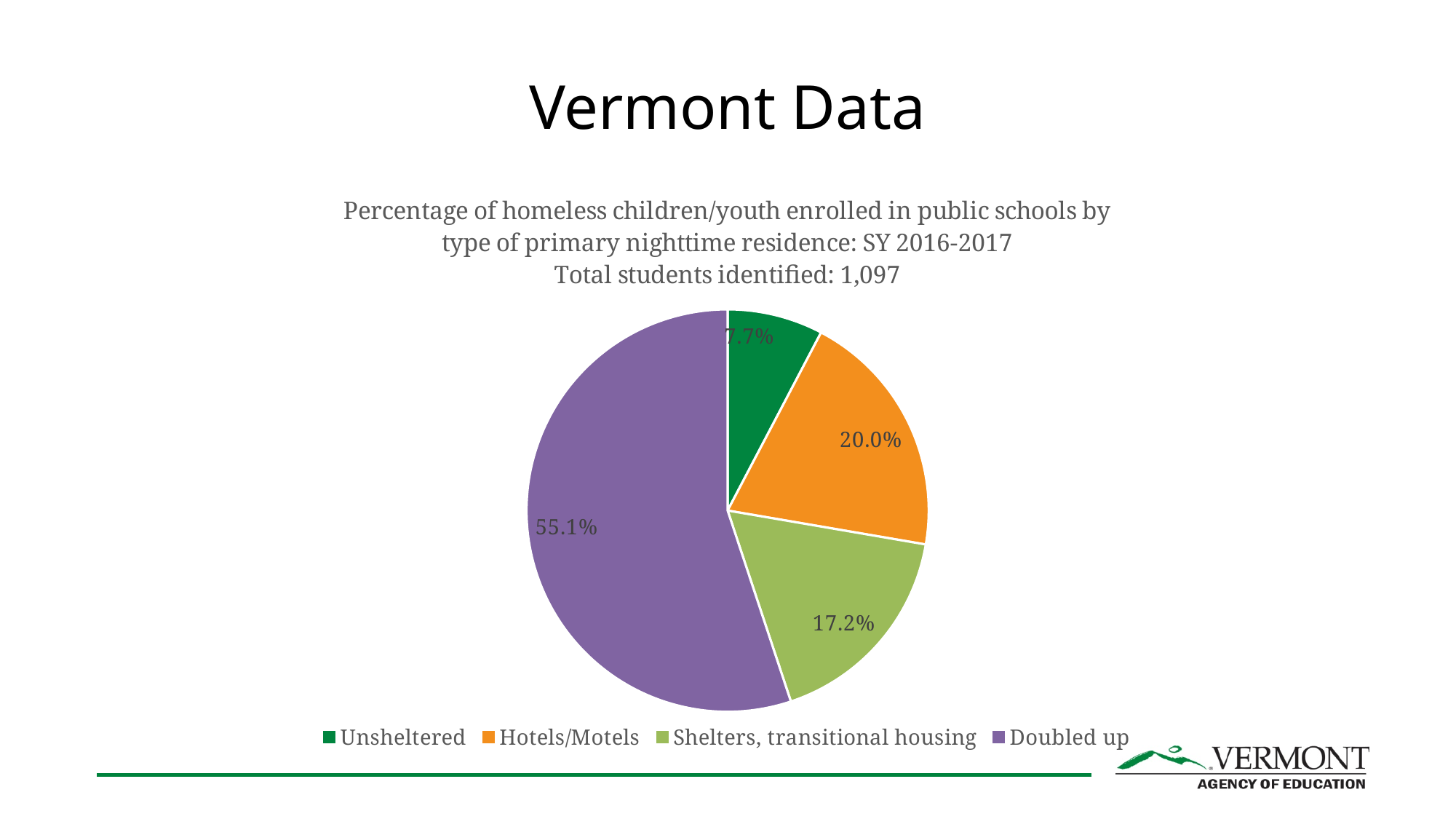
What is the total number of students identified, according to the chart title? 1,097 How many categories does the pie chart show? 4 Which type of primary nighttime residence has the smallest share of the pie? Unsheltered What percentage of homeless children/youth were in Shelters, transitional housing? 17.2% What percentage of homeless children/youth were in Hotels/Motels? 20.0% Which type of primary nighttime residence has the largest share of the pie? Doubled up What type of chart is shown on the slide? pie chart What is the difference in percentage points between Doubled up and Hotels/Motels? 35.1 What percentage of homeless children/youth were Unsheltered? 7.7% What percentage of homeless children/youth were Doubled up? 55.1% Which is larger, the share for Hotels/Motels or the share for Shelters, transitional housing? Hotels/Motels Which colour represents the Doubled up slice? purple